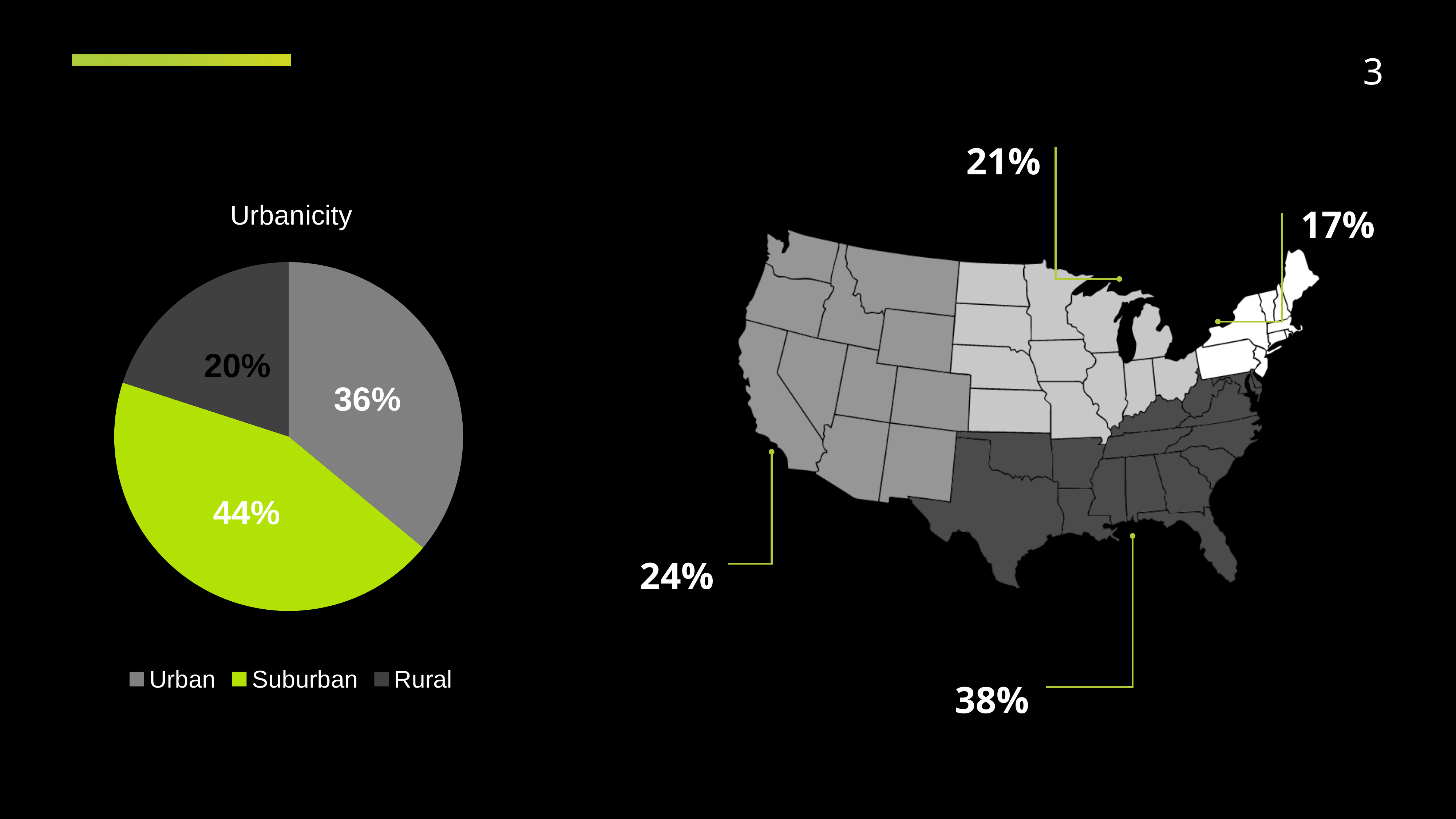
In the Urbanicity pie chart, what percentage is shown for Urban? 36% In the Urbanicity pie chart, how many percentage points larger is Suburban than Urban? 8% In the Urbanicity pie chart, which category has the smallest share? Rural In the Urbanicity pie chart, which category is shown in green? Suburban In the Urbanicity pie chart, what is the difference between the Urban and Rural shares? 16% In the Urbanicity pie chart, which is larger, Urban or Rural? Urban On the US map on the right of the slide, what is the highest percentage labeled? 38% In the Urbanicity pie chart, which category has the largest share? Suburban How many categories does the Urbanicity pie chart show? 3 In the Urbanicity pie chart, what percentage is shown for Rural? 20% What kind of chart is the Urbanicity chart on the left of the slide? Pie chart In the Urbanicity pie chart, what percentage is shown for Suburban? 44%